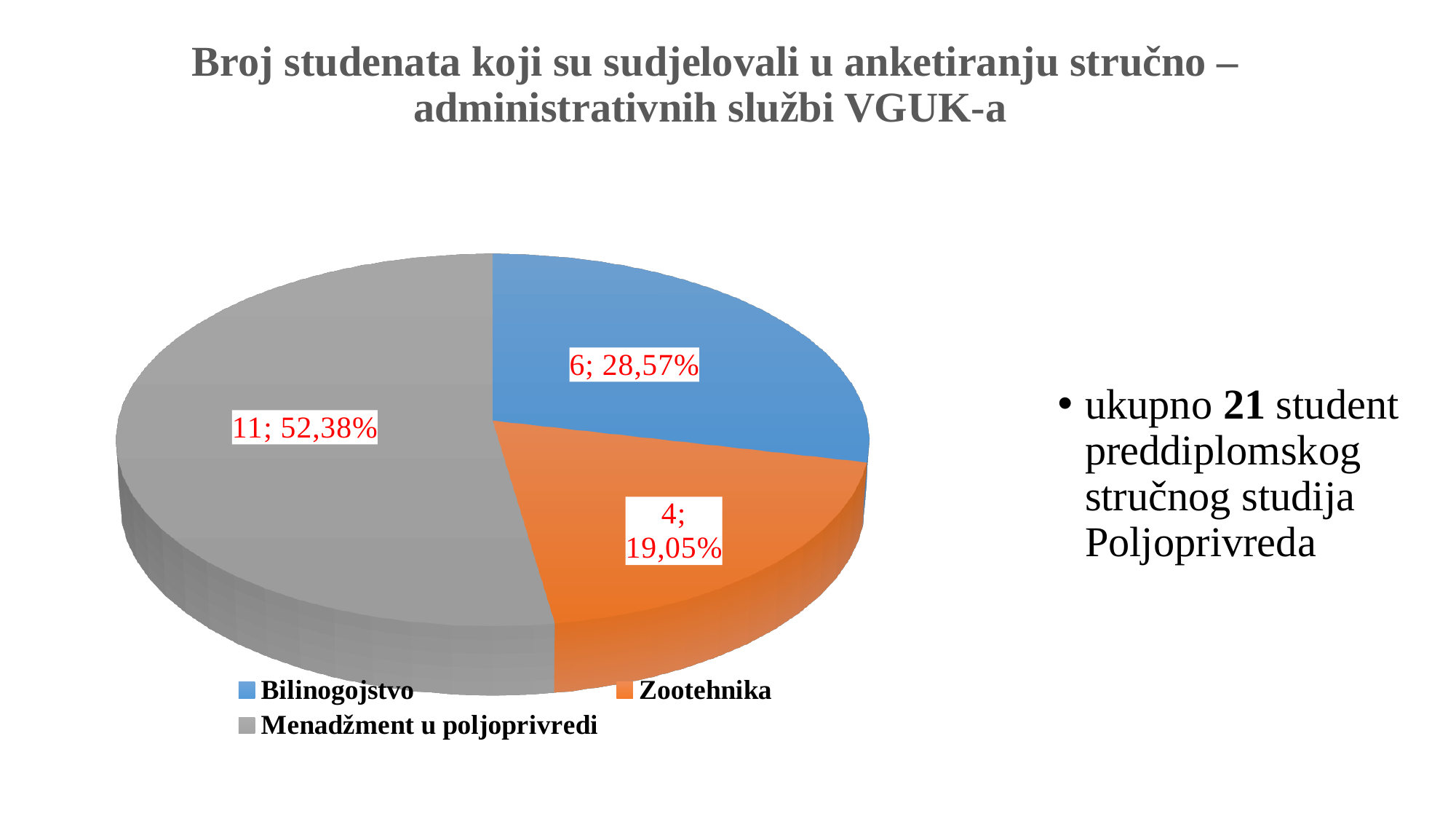
What share of the pie does Zootehnika represent? 19,05% What kind of chart is shown on the slide? pie chart What is the difference in number of students between Menadžment u poljoprivredi and Bilinogojstvo? 5 How many students are in the Bilinogojstvo slice? 6 Which category has the smallest slice? Zootehnika What share of the pie does Bilinogojstvo represent? 28,57% How many categories does the pie chart have? 3 How many students are in the Zootehnika slice? 4 How many students are in the Menadžment u poljoprivredi slice? 11 What share of the pie does Menadžment u poljoprivredi represent? 52,38% Which category has the largest slice? Menadžment u poljoprivredi Which has more students, Bilinogojstvo or Zootehnika? Bilinogojstvo